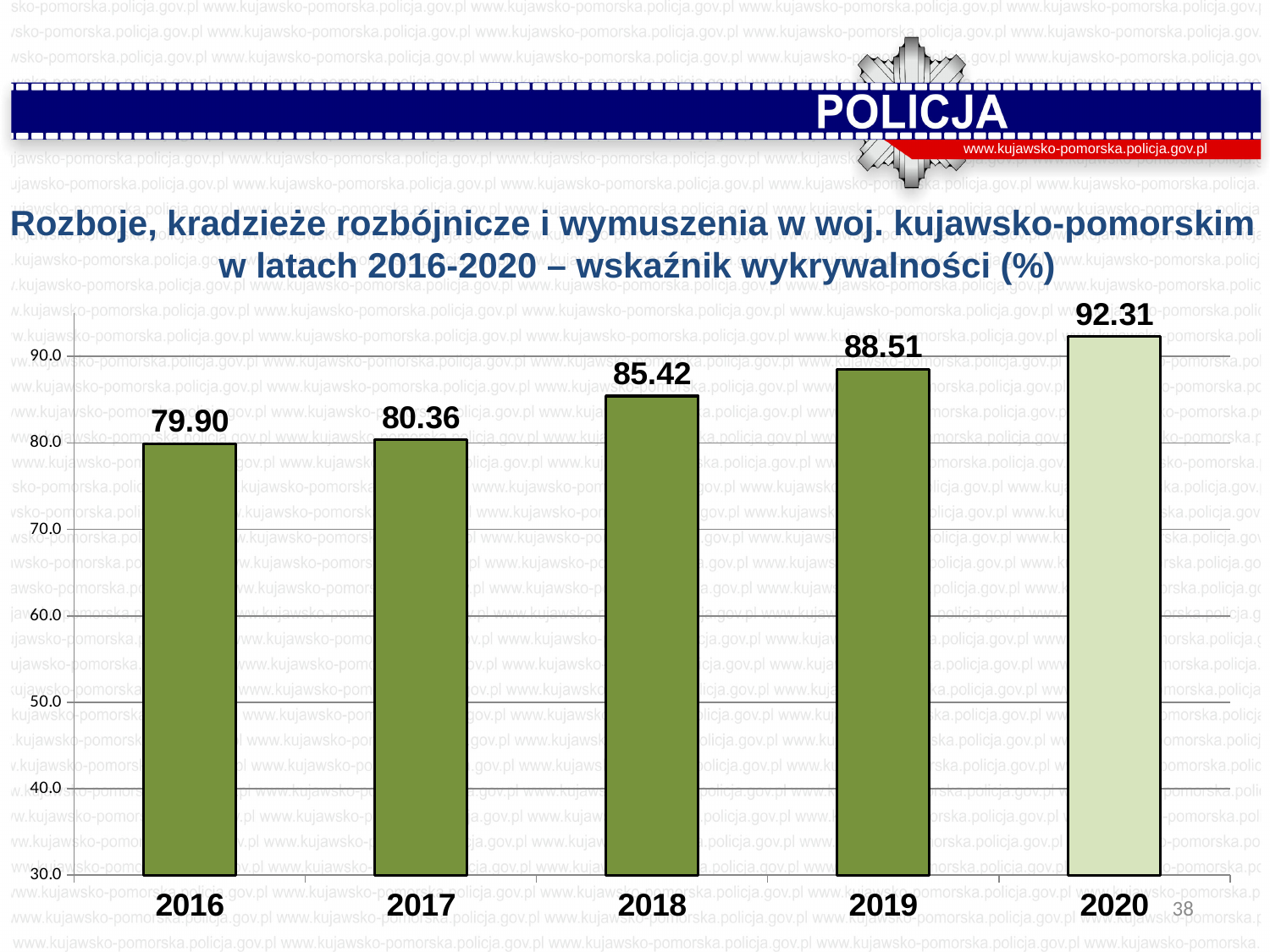
How many years are shown on the chart? 5 What is the difference between the values for 2019 and 2018? 3.09 What kind of chart is shown on the slide? bar chart Is the value for 2019 greater or less than 80.0? greater Do the values rise or fall from 2016 to 2020? rise What is the value shown for 2018? 85.42 Which year has the highest value? 2020 Which year has the lowest value? 2016 Which is larger, the value for 2017 or the value for 2019? 2019 What is the value shown for 2020? 92.31 What is the detection rate value shown for 2016? 79.90 What is the difference between the values for 2020 and 2016? 12.41